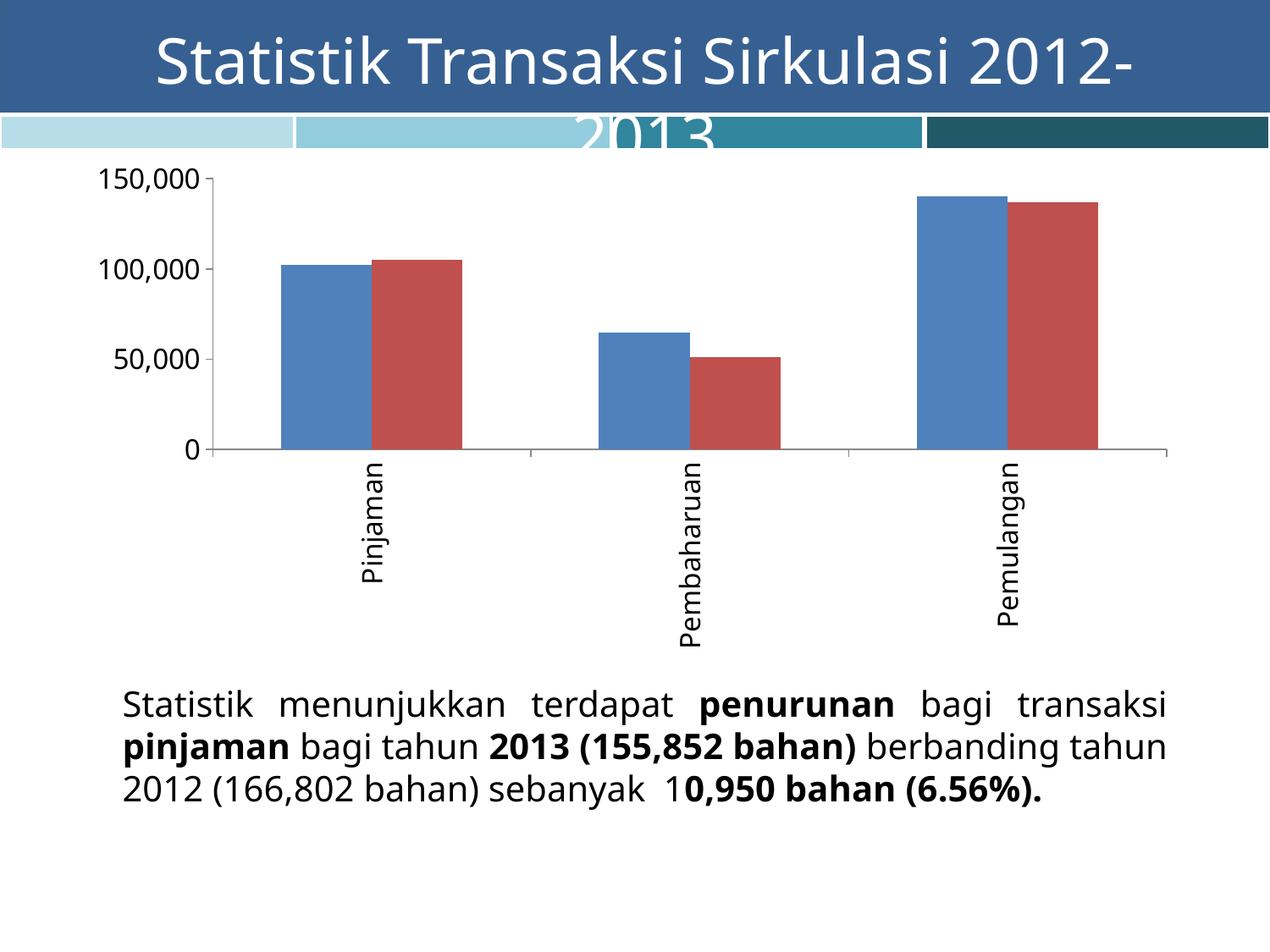
What kind of chart is shown on the slide? bar chart Which category has the lowest bars in the chart? Pembaharuan How many bars are plotted for each category in the chart? 2 How many categories are shown on the x axis of the chart? 3 What are the two colours used for the bars in the chart? blue and red Is the value of the red bar for Pinjaman greater or less than 100,000? greater Is the value of the blue bar for Pemulangan greater or less than 150,000? less Is the value of the red bar for Pemulangan greater or less than 100,000? greater What is the title of the slide containing the chart? Statistik Transaksi Sirkulasi 2012-2013 For Pembaharuan, which bar is taller, the blue bar or the red bar? the blue bar Which category has the highest bars in the chart? Pemulangan